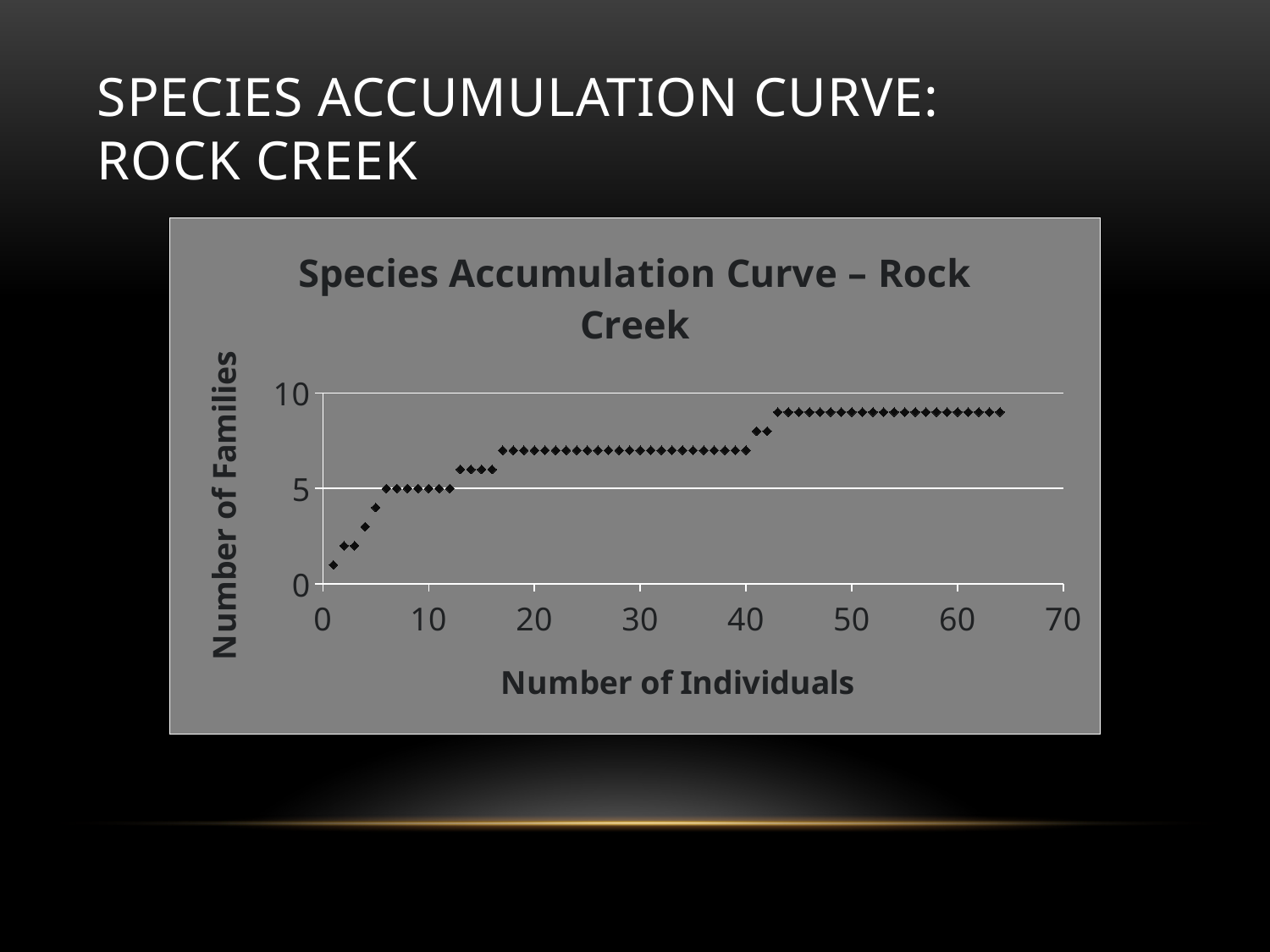
Which has the smaller number of families: 5 individuals or 40 individuals? 5 individuals What kind of chart is shown on the slide? scatter chart What is the label on the x axis of the chart? Number of Individuals Is the highest number of families reached on the chart greater or less than 10? less Which has the larger number of families: 50 individuals or 20 individuals? 50 individuals Is the number of families at 30 individuals greater or less than 5? greater Is the number of families at 1 individual greater or less than 5? less Do the values generally rise or fall as the number of individuals increases along the x axis? rise What is the number of families at 10 individuals? 5 What is the title of the chart? Species Accumulation Curve – Rock Creek